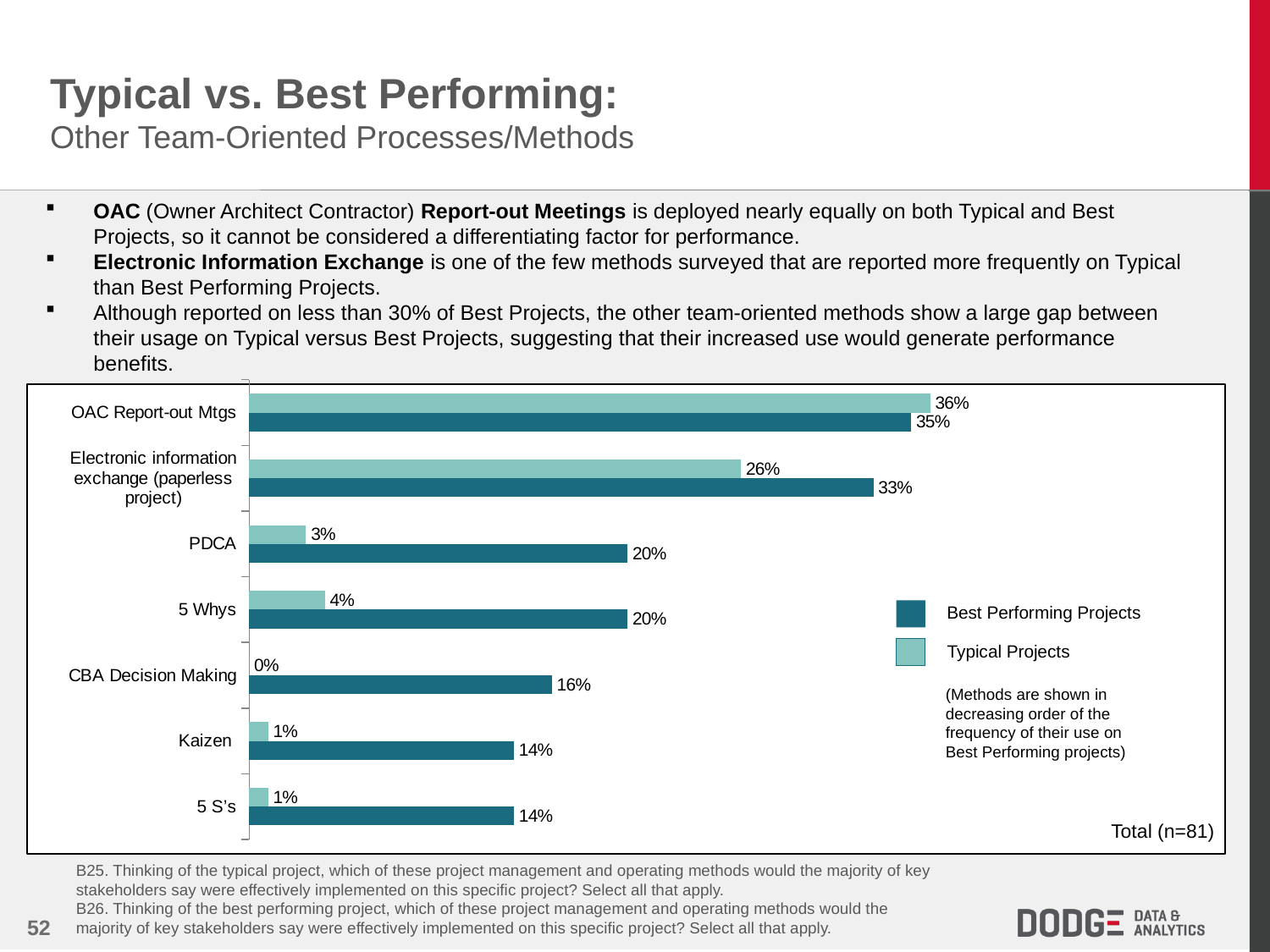
What is the value for Typical Projects for OAC Report-out Mtgs? 36% Which method has the highest value for Typical Projects? OAC Report-out Mtgs What is the difference between the Best Performing Projects and Typical Projects values for 5 Whys? 16% What is the value for Typical Projects for CBA Decision Making? 0% How many methods (categories) are plotted in the chart? 7 What is the value for Best Performing Projects for Electronic information exchange (paperless project)? 33% Which colour represents Typical Projects in the chart? light teal For Electronic information exchange (paperless project), which is larger: the Best Performing Projects value or the Typical Projects value? Best Performing Projects What type of chart is shown on the slide? bar chart Which method has the lowest value for Typical Projects? CBA Decision Making What is the value for Best Performing Projects for PDCA? 20% How many series does the legend list? 2